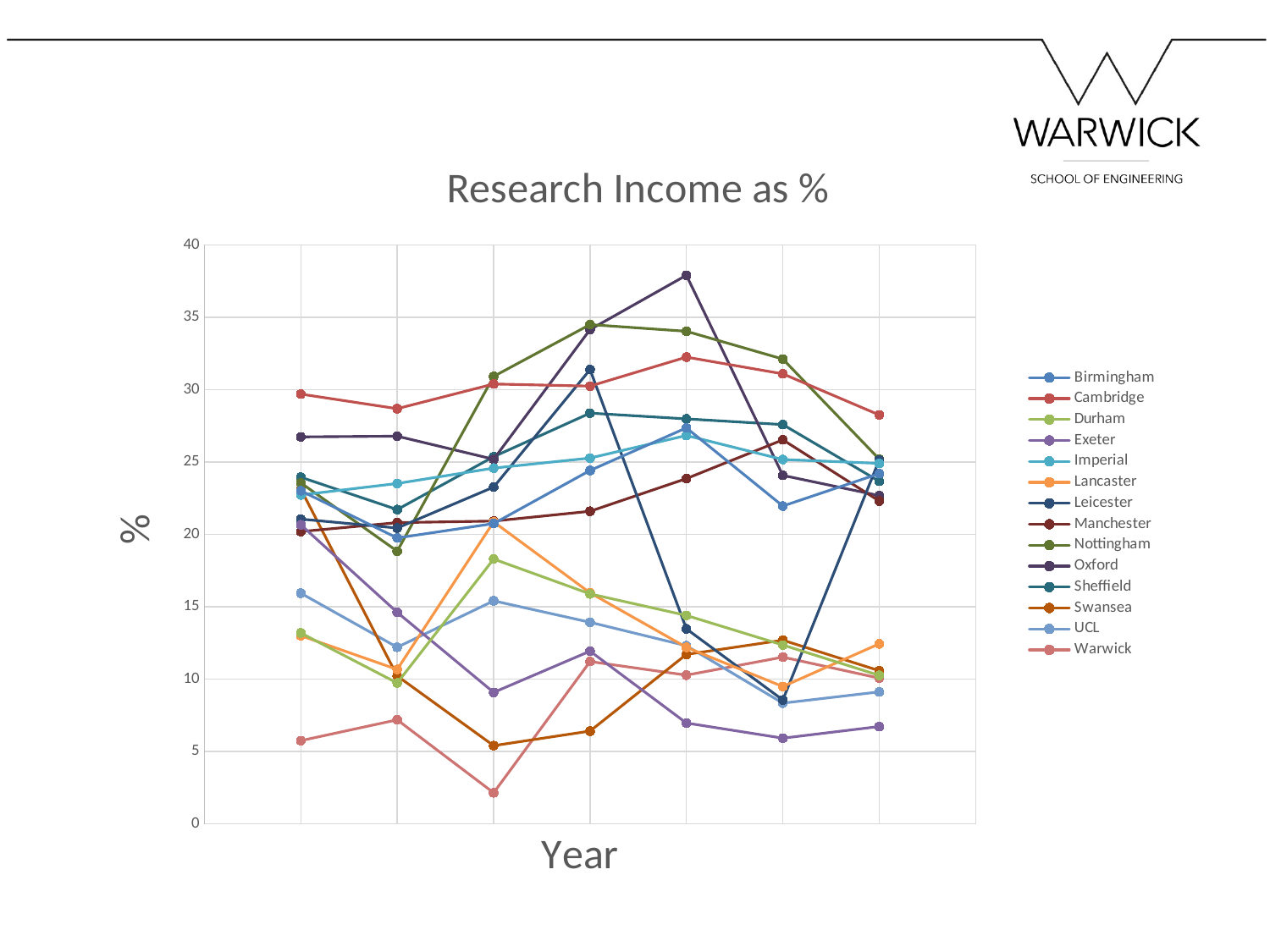
Which series reaches the highest value anywhere on the chart? Oxford Is the value for Warwick at the third point greater or less than 5? less How many data points does each line have? 7 Does the Warwick line rise or fall between the third and fourth points? rise What is the title of the chart? Research Income as % Is the value for Warwick at the leftmost point greater or less than 10? less Which series has the lowest point anywhere on the chart? Warwick At the fifth point, which is larger, Oxford or Nottingham? Oxford How many series does the legend list? 14 Is the highest value for Oxford greater or less than 35? greater What kind of chart is shown on the slide? line chart What is the label on the x axis of the chart? Year